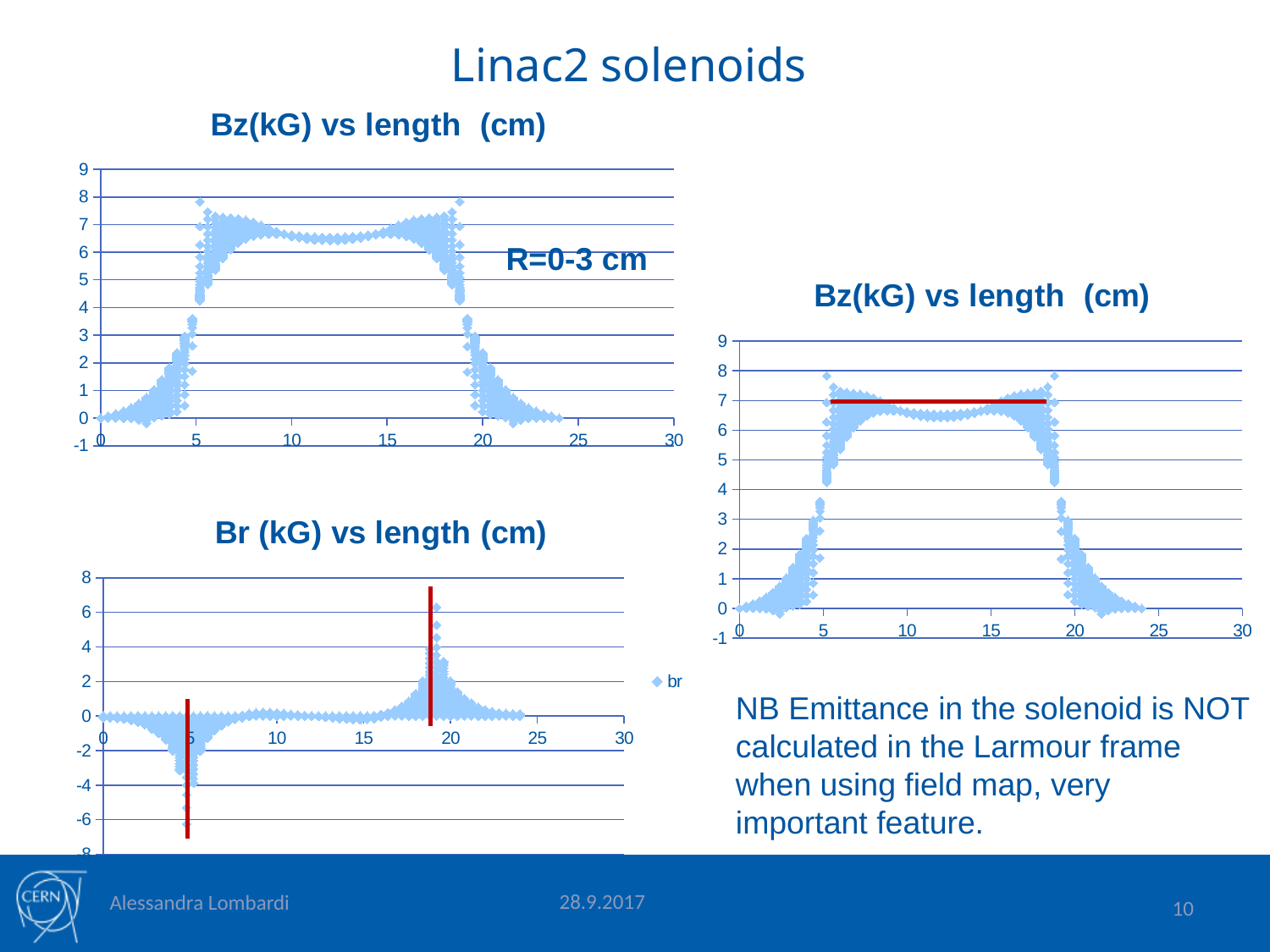
In the top-left "Bz(kG) vs length (cm)" chart, do the values rise or fall as length increases from 20 to 25 cm? fall In the top-left "Bz(kG) vs length (cm)" chart, which has the larger value: length 10 cm or length 25 cm? 10 cm In the "Br (kG) vs length (cm)" chart, is the peak value near a length of 19 cm greater or less than 4? greater In the top-left "Bz(kG) vs length (cm)" chart, is the value at a length of 25 cm greater or less than 1? less In the right-hand "Bz(kG) vs length (cm)" chart, is the value at a length of 12 cm greater or less than 5? greater How many series does the legend of the "Br (kG) vs length (cm)" chart list? 1 In the top-left "Bz(kG) vs length (cm)" chart, do the values rise or fall as length increases from 0 to 5 cm? rise What is the name of the series shown in the legend of the "Br (kG) vs length (cm)" chart? br What kind of chart is the top-left chart titled "Bz(kG) vs length (cm)"? scatter chart What is the title of the chart on the right side of the slide? Bz(kG) vs length (cm)